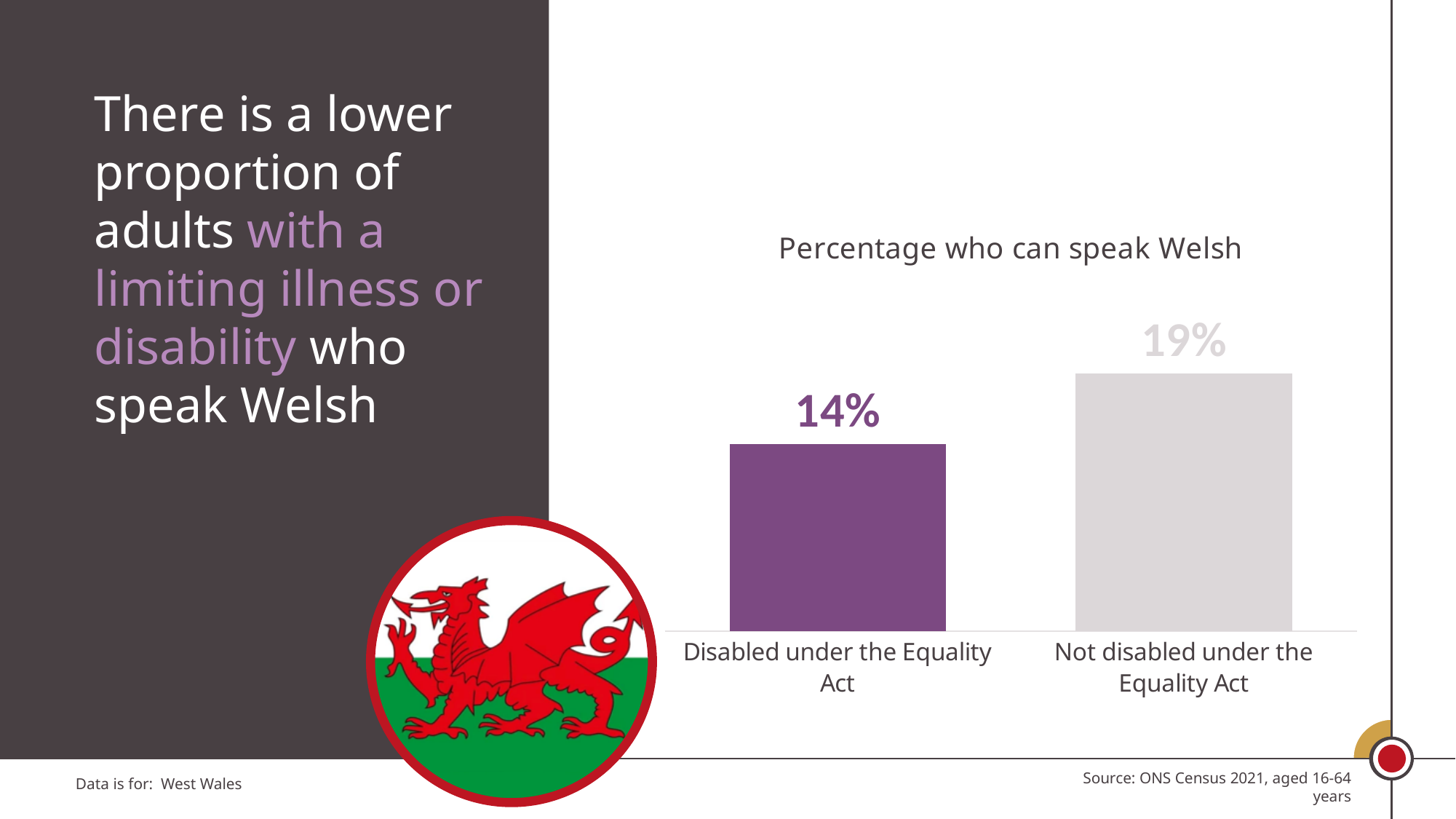
What is the percentage who can speak Welsh for those disabled under the Equality Act? 14% Is the value for disabled under the Equality Act larger or smaller than the value for not disabled under the Equality Act? smaller What is the title of the chart? Percentage who can speak Welsh What kind of chart is shown on the slide? Bar chart How many categories are shown in the chart? 2 What is the percentage who can speak Welsh for those not disabled under the Equality Act? 19% Which category has the lower percentage who can speak Welsh? Disabled under the Equality Act What is the difference in percentage points between the not disabled and disabled categories? 5 percentage points What colour is the bar for disabled under the Equality Act? Purple Which category has the higher percentage who can speak Welsh? Not disabled under the Equality Act